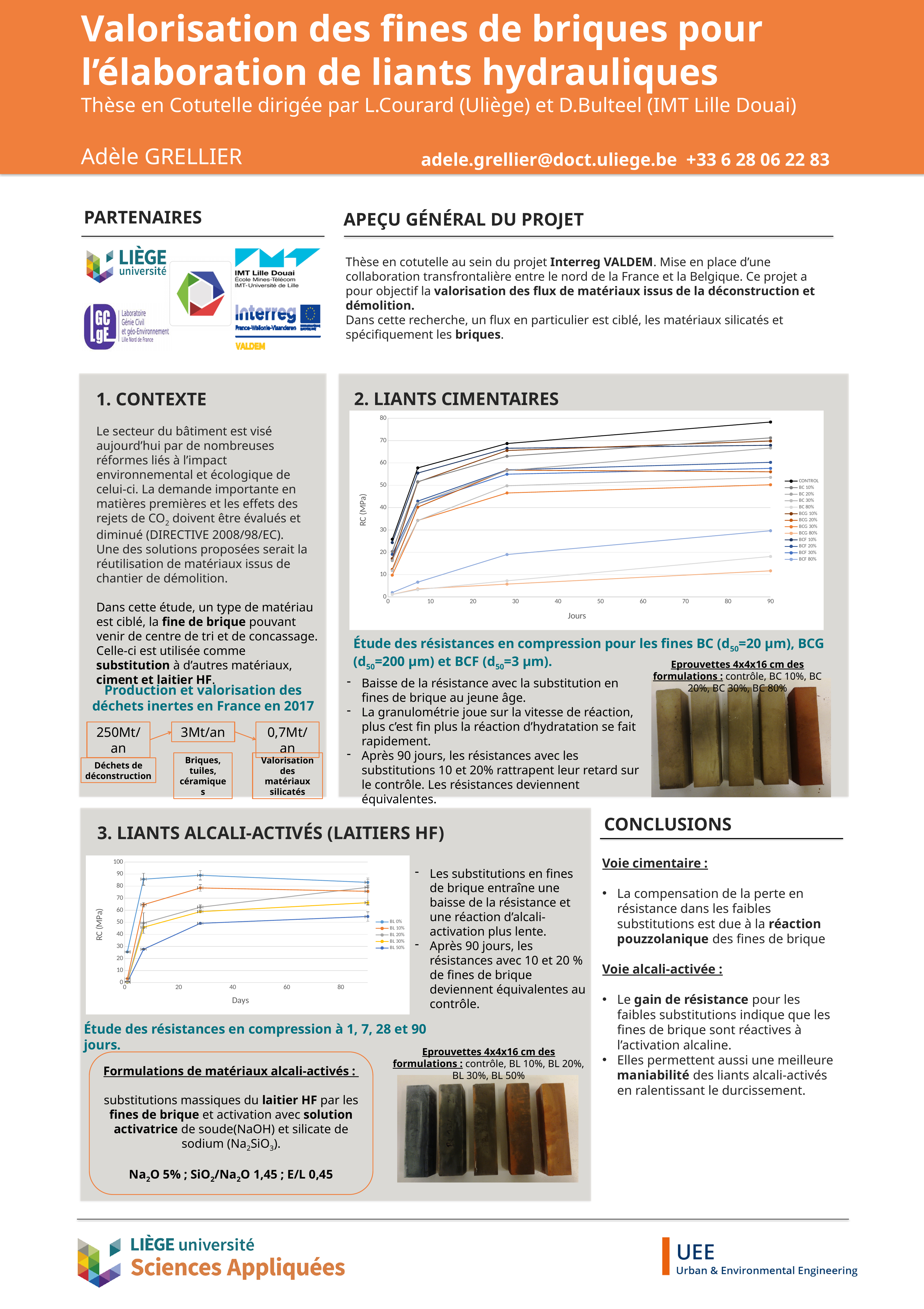
In the chart in section 2, 'Liants cimentaires', which series has the highest value at 90 days? CONTROL In the chart in section 2, 'Liants cimentaires', do the values generally rise or fall as the number of days increases? rise In the chart in section 3, 'Liants alcali-activés', which series has the lowest value at 90 days? BL 50% How many series does the legend of the chart in section 2, 'Liants cimentaires', list? 13 In the chart in section 3, 'Liants alcali-activés', is the value for BL 10% at 90 days greater or less than 70? greater What is the y-axis label of the chart in section 2, 'Liants cimentaires'? RC (MPa) What is the x-axis label of the chart in section 3, 'Liants alcali-activés'? Days How many series does the legend of the chart in section 3, 'Liants alcali-activés', list? 5 In the chart in section 2, 'Liants cimentaires', is the value for BCF 80% at 90 days greater or less than 20? greater What kind of chart is shown in section 2, 'Liants cimentaires'? line chart In the chart in section 2, 'Liants cimentaires', is the value for CONTROL at 90 days greater or less than 70? greater In the chart in section 2, 'Liants cimentaires', which series has the lowest value at 90 days? BCG 80%